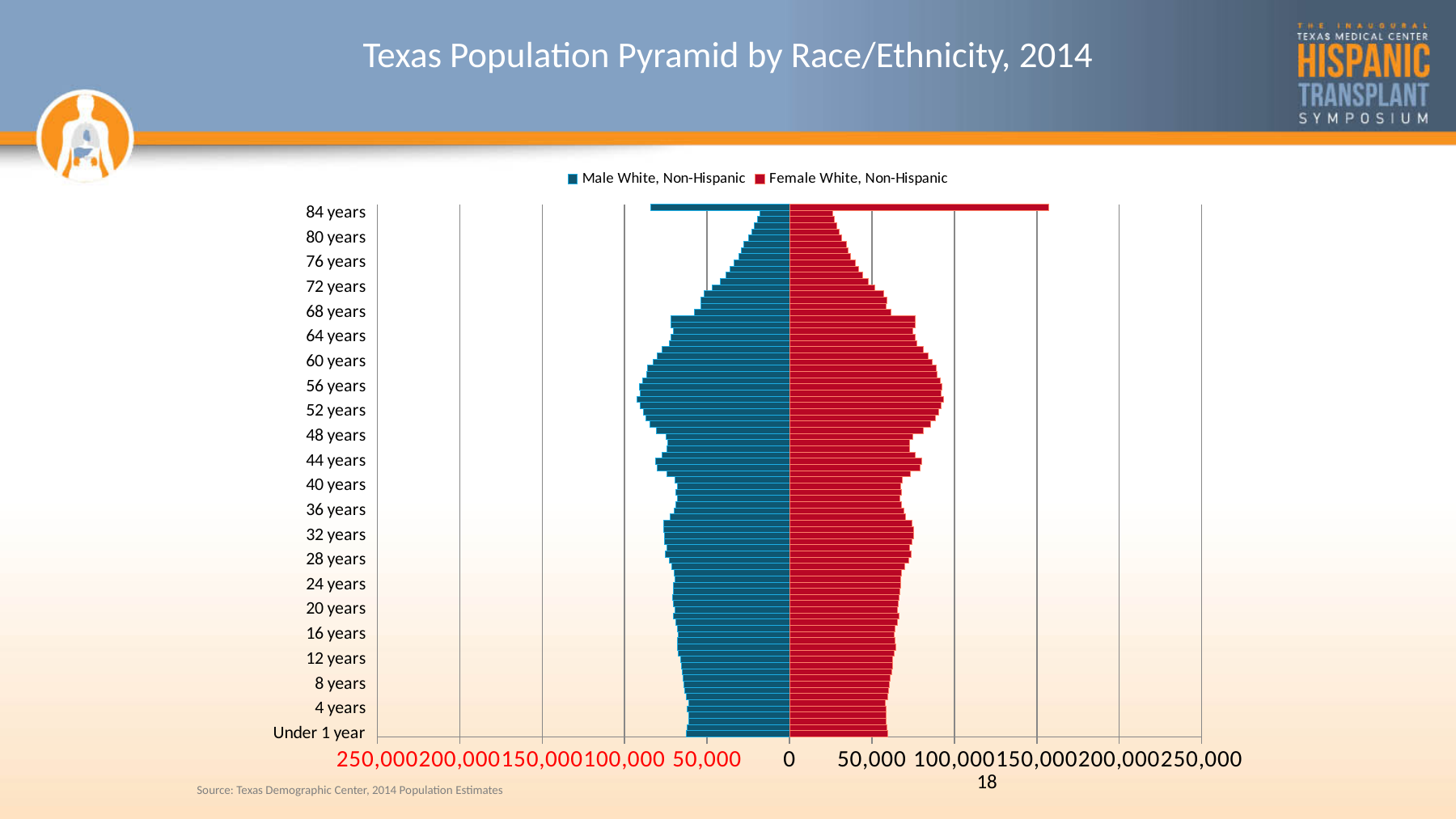
Is the Male White, Non-Hispanic value at 84 years greater or less than 50,000? less What kind of chart is shown on the slide? Bar chart Is the Female White, Non-Hispanic value at 76 years greater or less than 100,000? less How many series does the legend list? 2 Is the Female White, Non-Hispanic value at 84 years greater or less than 100,000? less Which Female White, Non-Hispanic bar is longer: 56 years or 4 years? 56 years Which series is shown in red? Female White, Non-Hispanic What is the title of the chart? Texas Population Pyramid by Race/Ethnicity, 2014 At 84 years, which bar is longer: Male White, Non-Hispanic or Female White, Non-Hispanic? Female White, Non-Hispanic